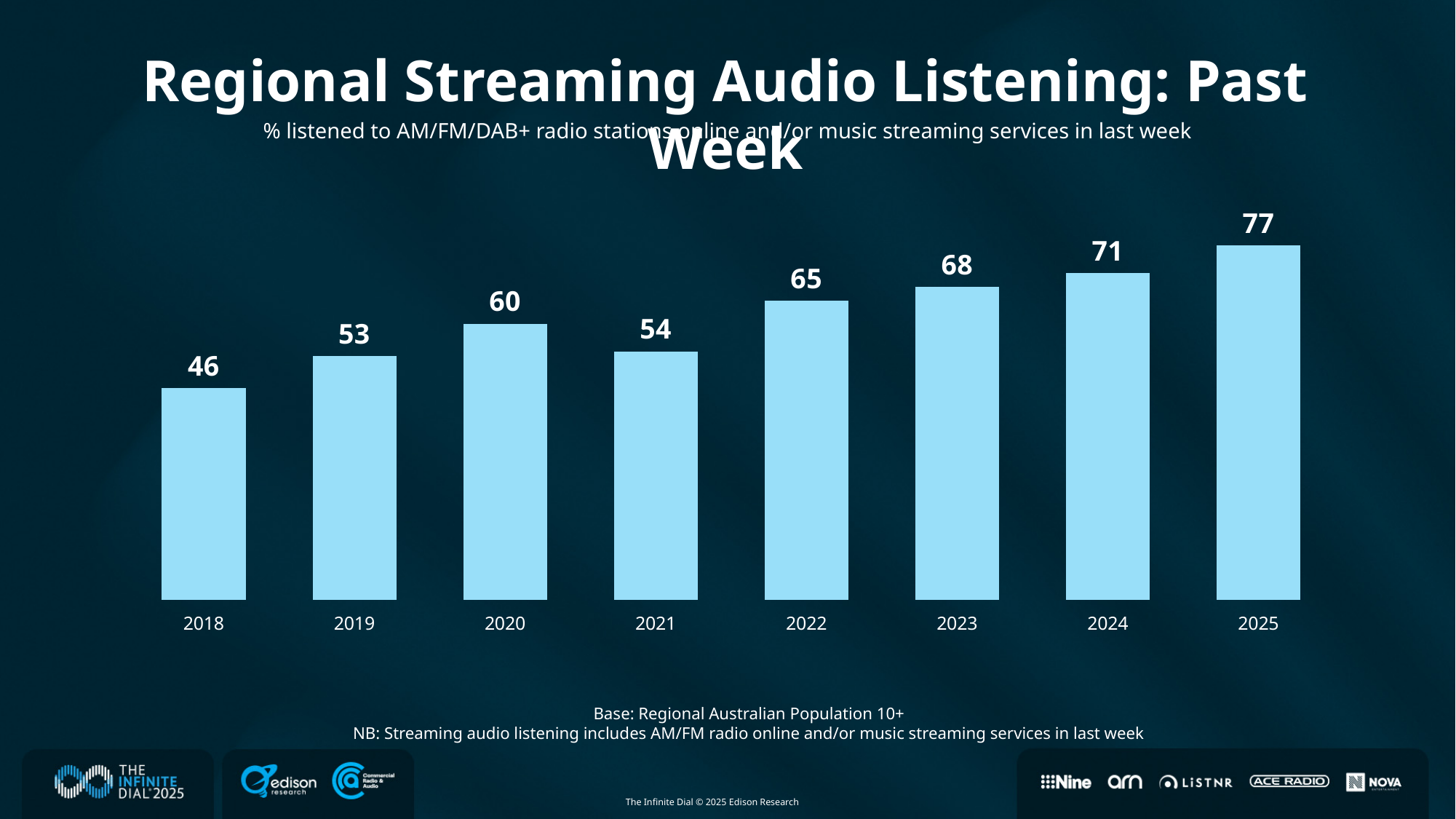
How many years are shown on the chart? 8 What kind of chart is shown on the slide? Bar chart Which year has the lowest value? 2018 Do the values generally rise or fall from 2021 to 2025? Rise Which year has the highest value? 2025 What is the value for 2025? 77 What is the value for 2018? 46 What is the difference between the values for 2020 and 2021? 6 What is the value for 2021? 54 What is the title of the chart? Regional Streaming Audio Listening: Past Week What is the difference between the values for 2025 and 2018? 31 Which is larger, the value for 2020 or the value for 2021? 2020